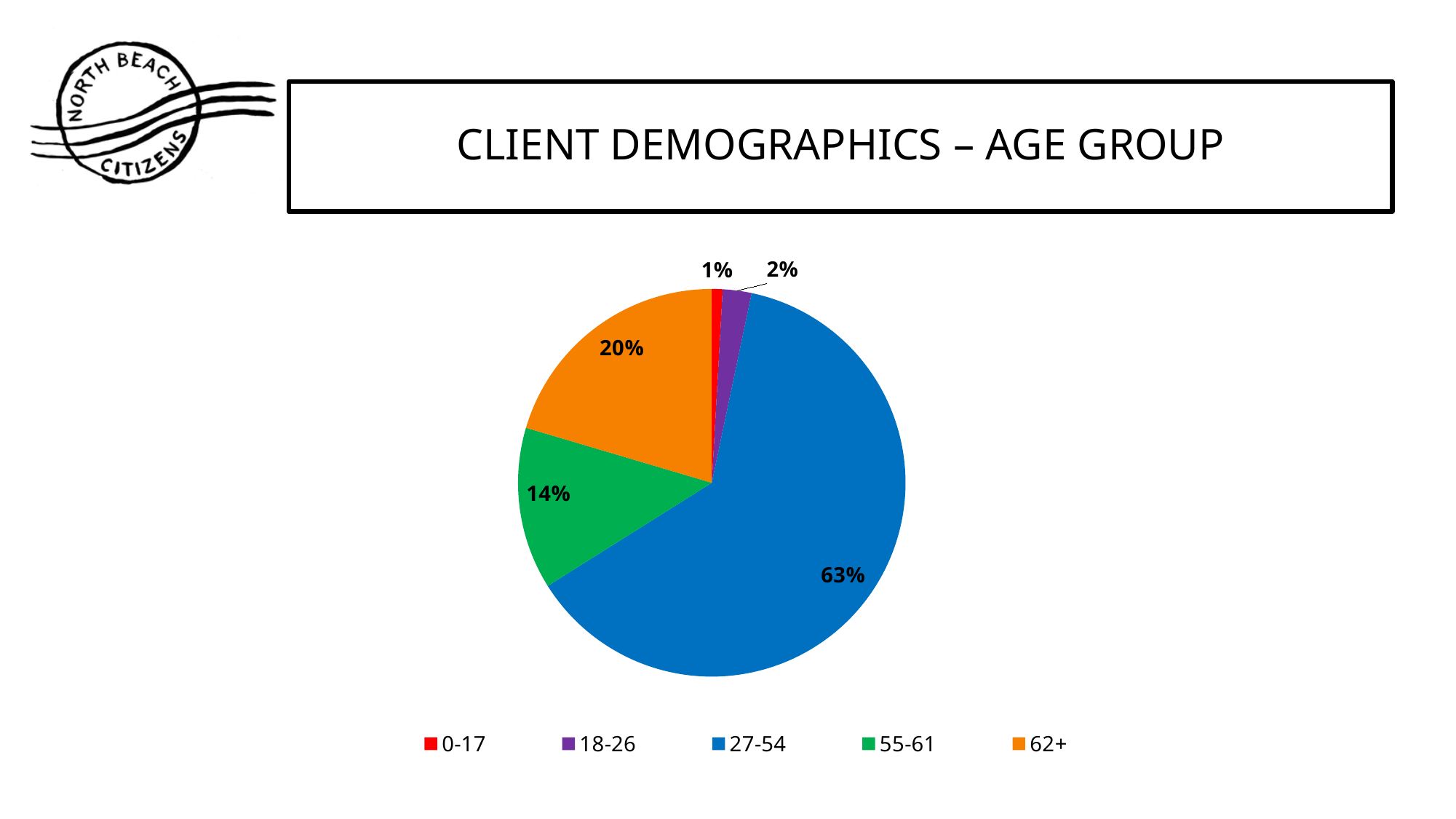
What share of clients are in the 27-54 age group? 63% How many percentage points larger is the 62+ share than the 55-61 share? 6 What share of clients are in the 18-26 age group? 2% Which age group has the smallest share of clients? 0-17 What share of clients are in the 55-61 age group? 14% What kind of chart is shown on the slide? Pie chart What is the title of the chart? CLIENT DEMOGRAPHICS – AGE GROUP Which age group has the largest share of clients? 27-54 What share of clients are in the 62+ age group? 20% What share of clients are in the 0-17 age group? 1% Which age group has a larger share, 55-61 or 62+? 62+ How many age groups are shown in the pie chart? 5